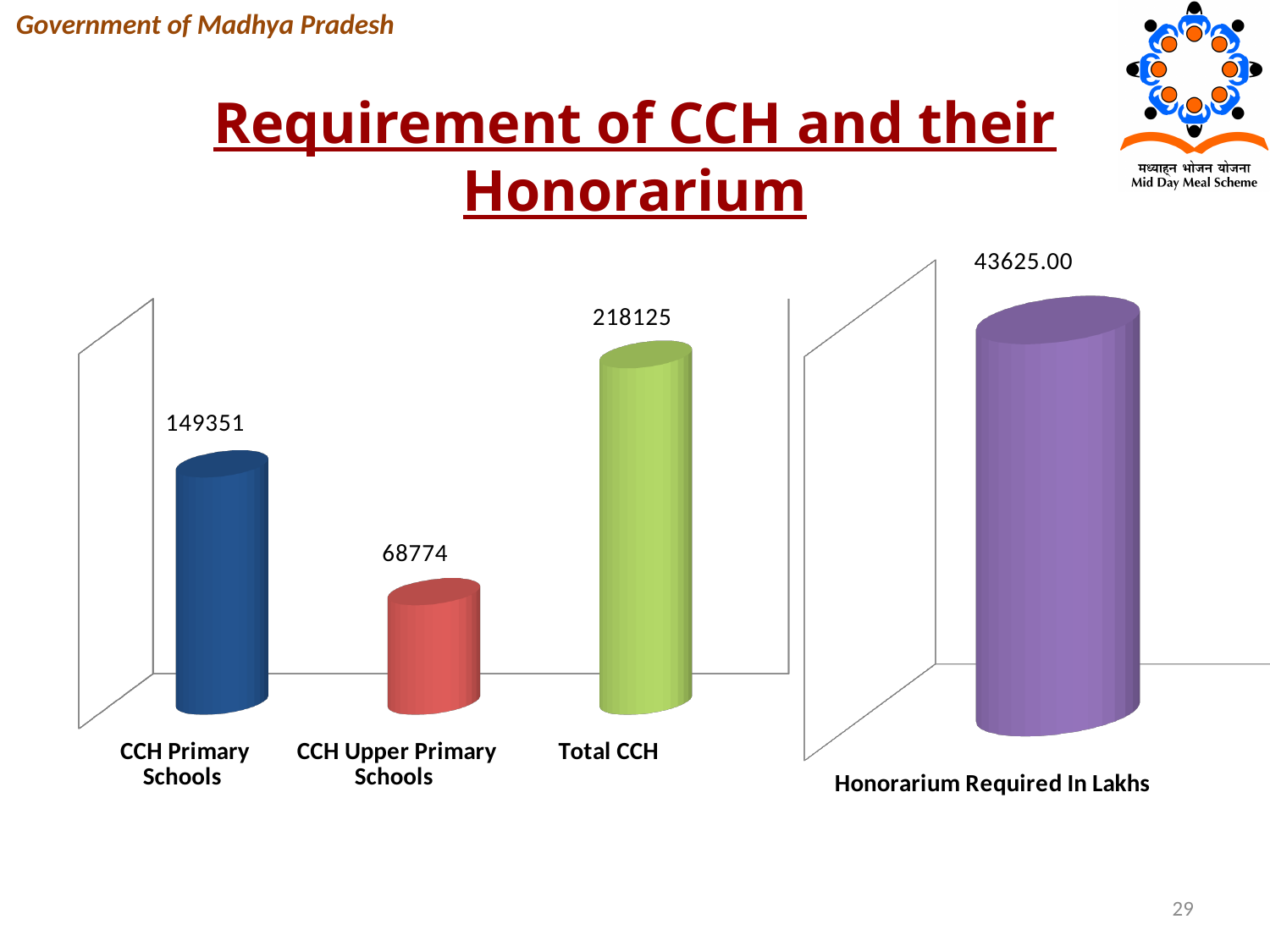
What colour is the bar for Total CCH in the left chart? Green What kind of chart is the left chart? Bar chart In the left chart, what is the value for Total CCH? 218125 How many categories are shown in the right chart? 1 In the left chart, which category has the highest value? Total CCH In the left chart, what is the difference between the values for CCH Primary Schools and CCH Upper Primary Schools? 80577 In the right chart, what is the value for Honorarium Required In Lakhs? 43625.00 How many categories are shown in the left chart? 3 In the left chart, what is the value for CCH Primary Schools? 149351 In the left chart, what is the value for CCH Upper Primary Schools? 68774 In the left chart, which is larger: the value for CCH Primary Schools or the value for CCH Upper Primary Schools? CCH Primary Schools In the left chart, which category has the lowest value? CCH Upper Primary Schools